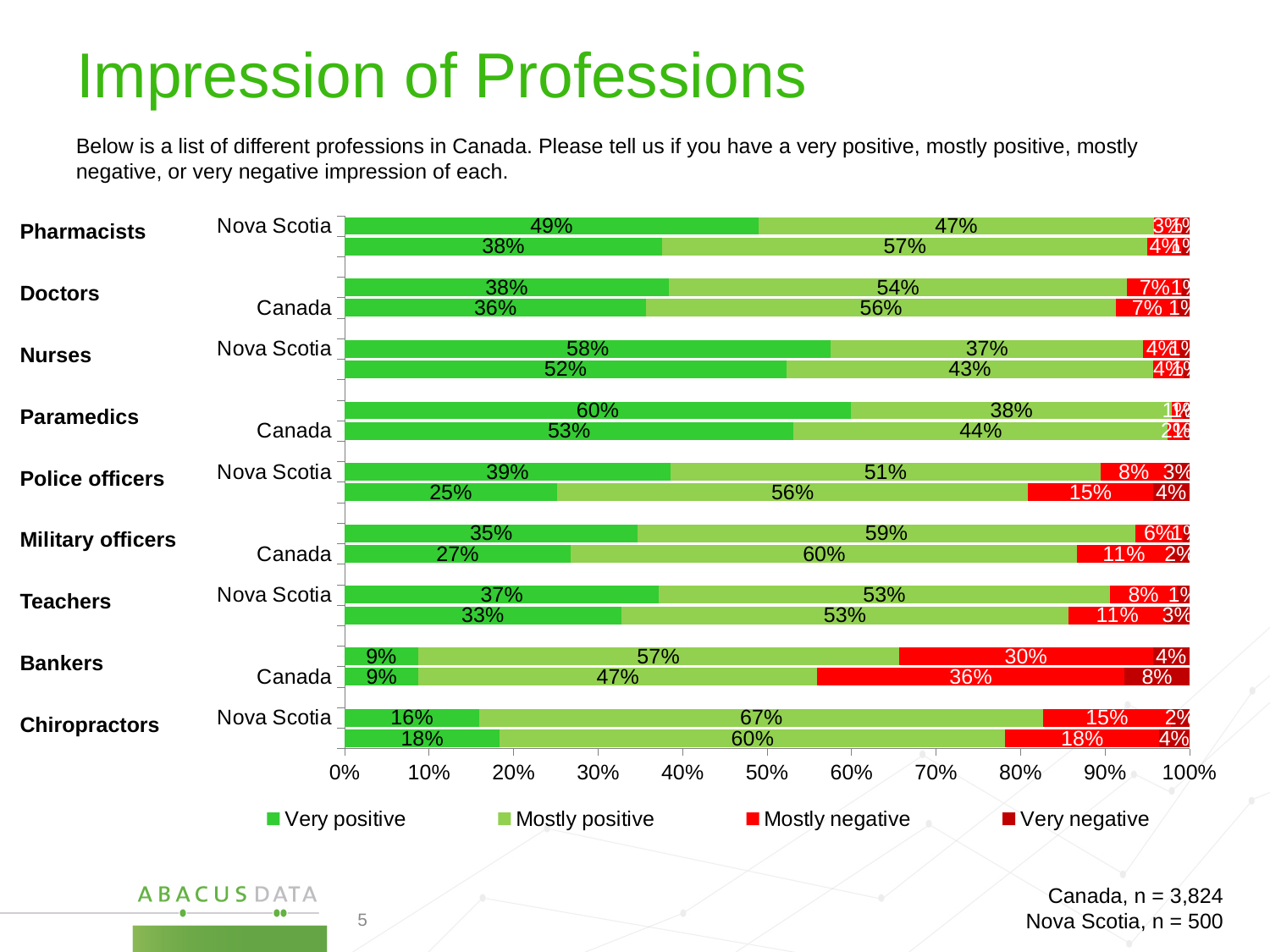
Which profession has the highest very positive share among Nova Scotia respondents? Paramedics How many professions are shown on the chart? 9 What percentage of Canada respondents have a mostly negative impression of Bankers? 36% What percentage of Nova Scotia respondents have a mostly positive impression of Chiropractors? 67% What percentage of Nova Scotia respondents have a very positive impression of Paramedics? 60% Which is larger: the mostly negative share for Bankers in Nova Scotia or in Canada? Canada What is the difference between the very positive share for Nurses in Nova Scotia and in Canada? 6% What percentage of Canada respondents have a very positive impression of Police officers? 25% Which profession has the lowest very positive share among Canada respondents? Bankers How many series does the legend list? 4 What type of chart is shown on the slide? Stacked bar chart What colour represents the 'Very negative' series in the legend? Dark red